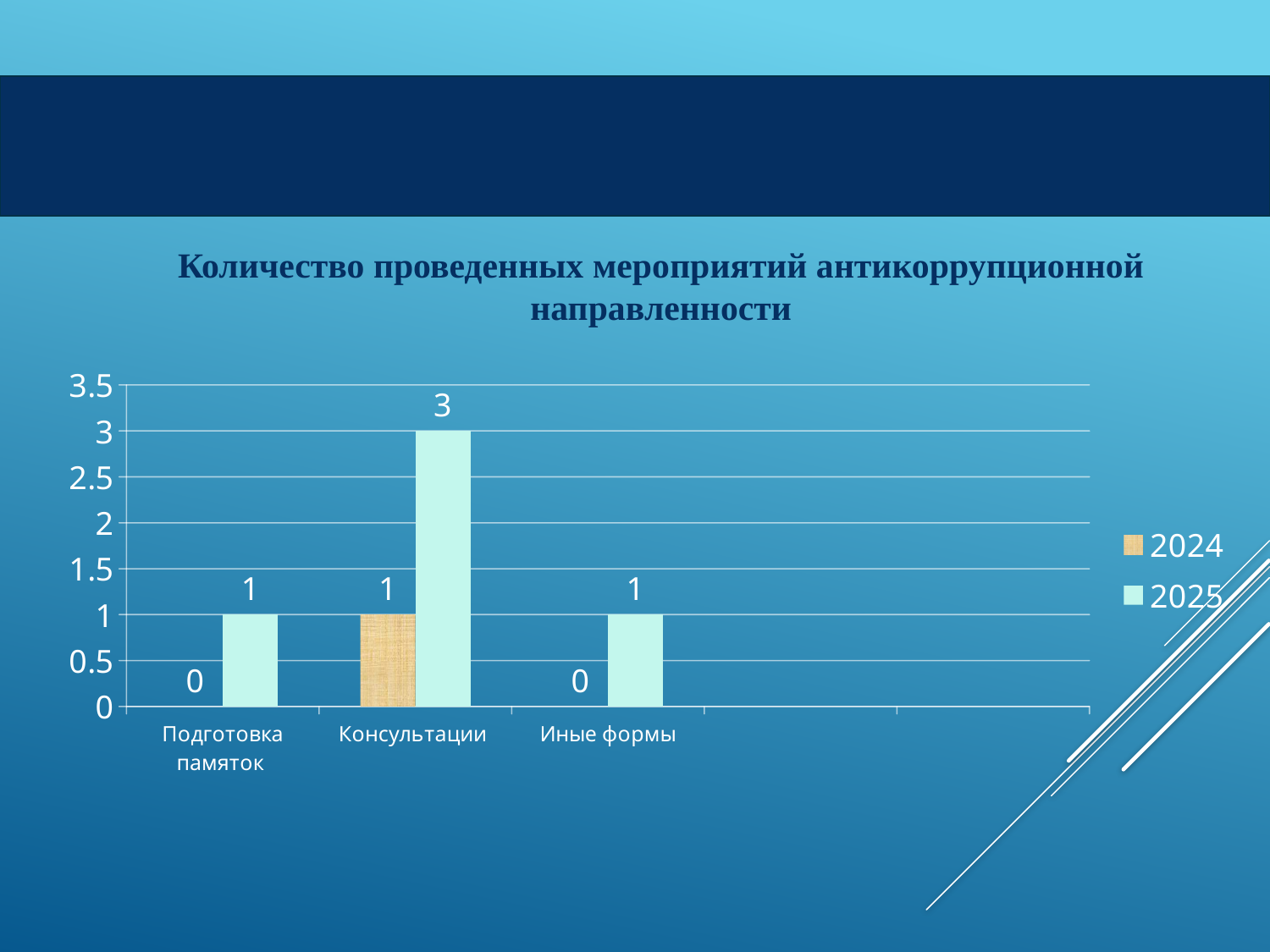
Which category has the highest value for 2025? Консультации What is the value for 2025 in the Иные формы category? 1 Is the 2025 value for Консультации greater or less than 2? greater What kind of chart is shown on the slide? bar chart Which is larger for Консультации: the 2024 value or the 2025 value? 2025 What is the value for 2024 in the Подготовка памяток category? 0 What is the value for 2025 in the Консультации category? 3 What is the difference between the 2025 and 2024 values for Консультации? 2 How many categories are labelled on the x axis? 3 How many series does the legend list? 2 What is the value for 2024 in the Консультации category? 1 What is the title of the chart? Количество проведенных мероприятий антикоррупционной направленности